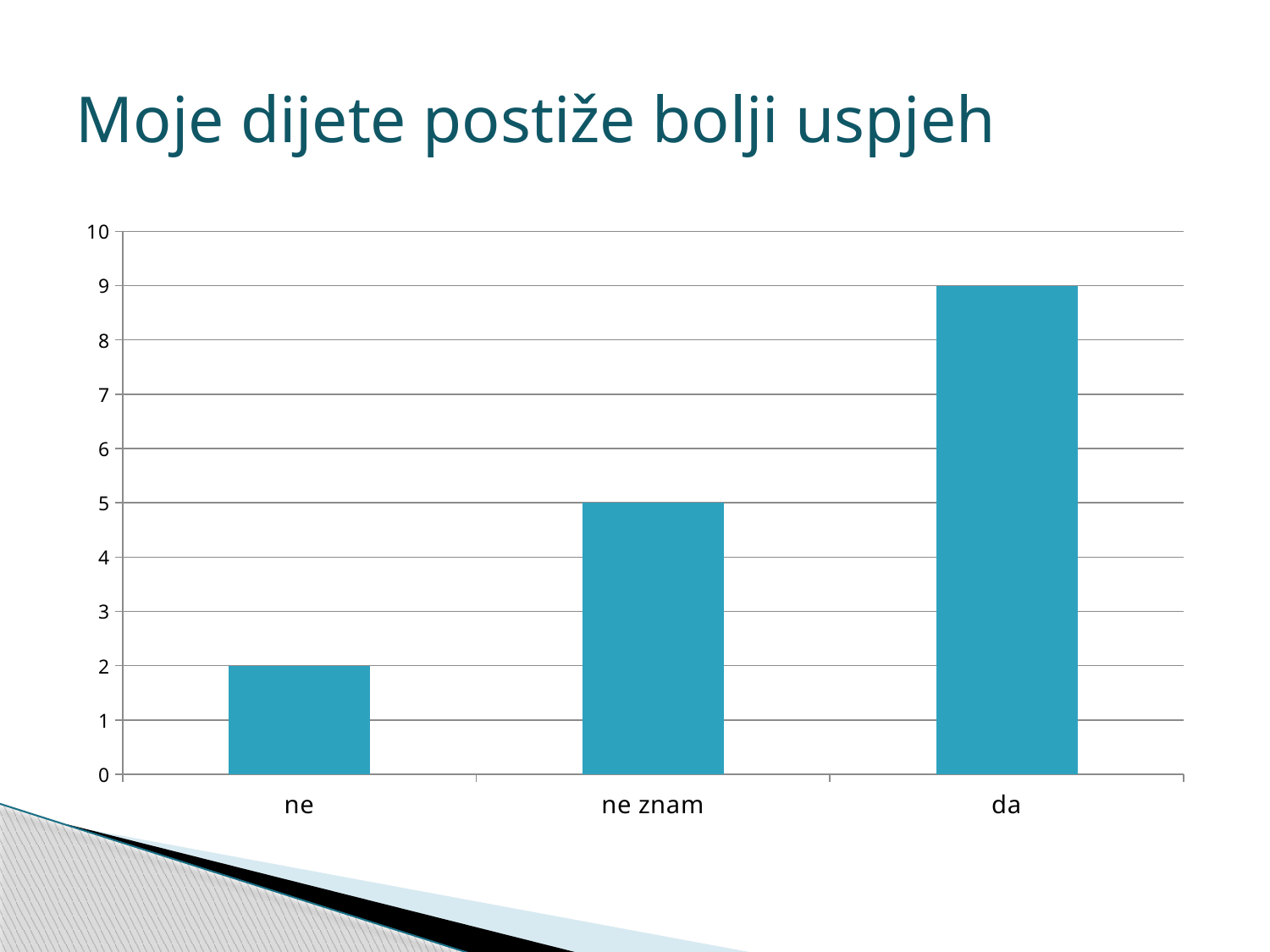
How many categories are shown on the x axis? 3 Is the value for "da" greater or less than 8? greater What is the value for "ne znam"? 5 What is the difference between the values for "ne znam" and "ne"? 3 What is the value for "da"? 9 What is the value for "ne"? 2 Which category has the highest value? da Which category has the lowest value? ne What kind of chart is shown on the slide? bar chart What is the difference between the values for "da" and "ne"? 7 Which is larger, the value for "ne znam" or the value for "da"? da What is the title of the slide? Moje dijete postiže bolji uspjeh